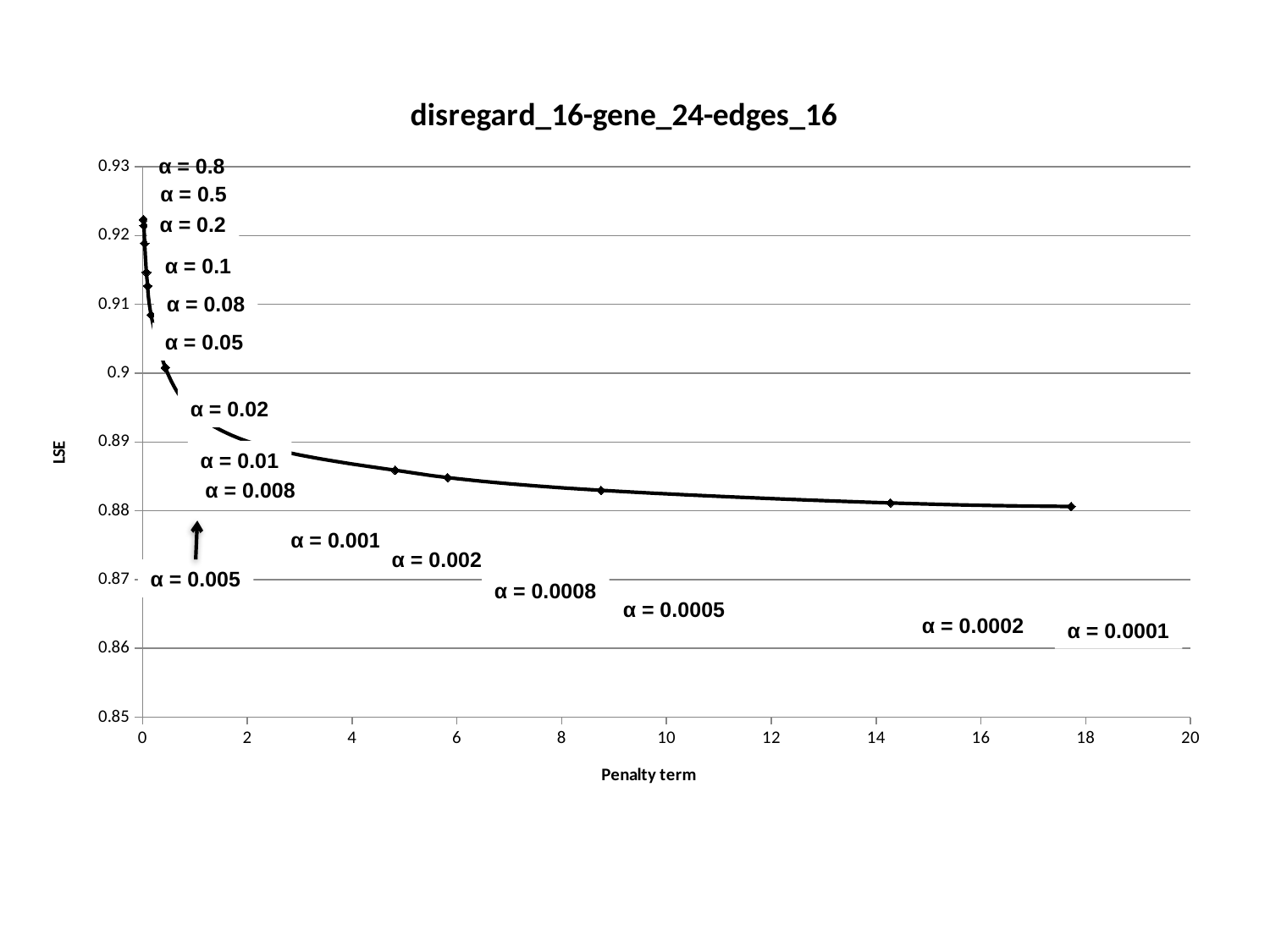
What kind of chart is shown on the slide? line chart Is the LSE value for the point labelled α = 0.8 greater or less than 0.91? greater Which labelled α value corresponds to the point with the highest LSE? α = 0.8 How many α labels are shown on the chart? 16 As the penalty term increases along the x axis, does LSE rise or fall? fall Which labelled α value corresponds to the point with the lowest LSE? α = 0.0001 Is the LSE value for the point labelled α = 0.05 greater or less than 0.91? less Is the LSE value for the point labelled α = 0.0001 greater or less than 0.89? less Which point has the higher LSE, the one labelled α = 0.8 or the one labelled α = 0.0001? α = 0.8 What is the label of the x axis? Penalty term What is the title of the chart? disregard_16-gene_24-edges_16